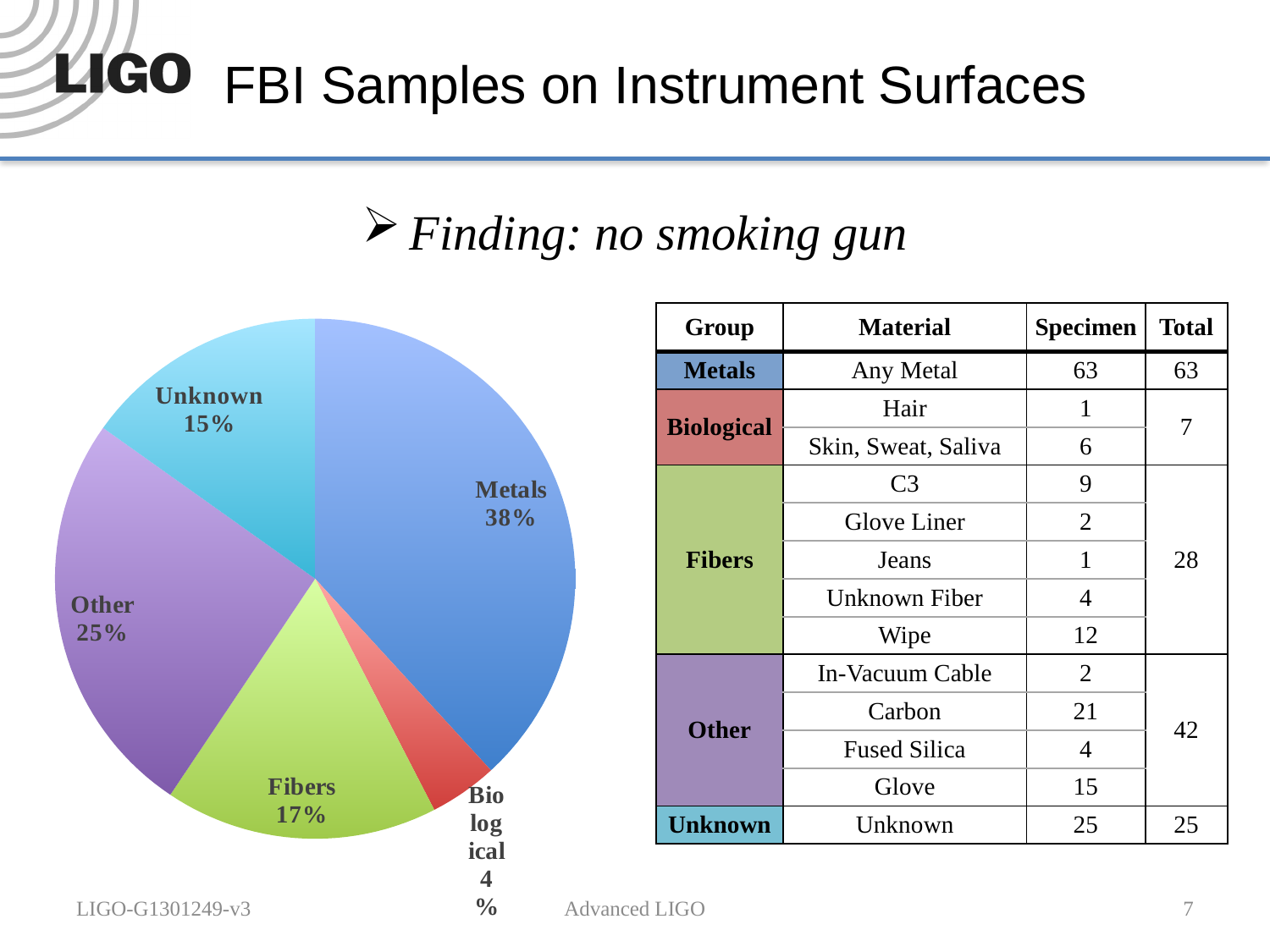
What share of the pie does Unknown represent? 15% What kind of chart is shown on the slide? pie chart What share of the pie does Fibers represent? 17% What colour is the Metals slice in the pie chart? blue How many slices does the pie chart have? 5 Which slice of the pie chart is the smallest? Biological What share of the pie does Metals represent? 38% Which slice is larger, Fibers or Unknown? Fibers Which slice of the pie chart is the largest? Metals What is the difference in percentage points between the Metals slice and the Other slice? 13